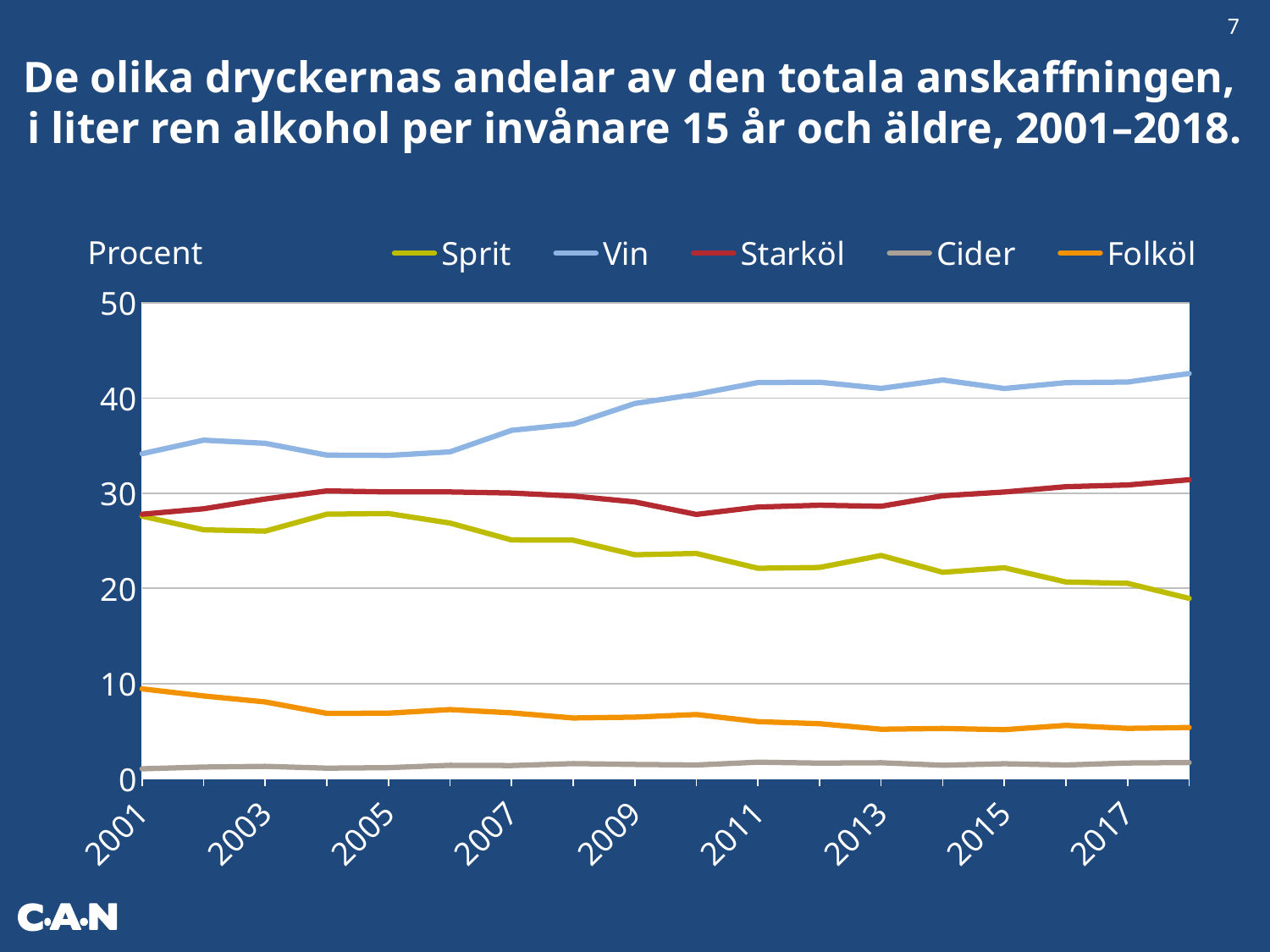
Is the value for Sprit in 2018 greater or less than 20? less How many series does the legend list? 5 Which series has the highest value in 2018? Vin What kind of chart is shown on the slide? line chart Does the value for Vin rise or fall from 2001 to 2018? rise Is the value for Vin in 2018 greater or less than 40? greater Is the value for Starköl in 2018 greater or less than 30? greater Which is larger in 2018, the value for Starköl or the value for Sprit? Starköl Which is larger in 2011, the value for Vin or the value for Folköl? Vin Which series has the lowest value across the whole period? Cider Does the value for Sprit rise or fall from 2001 to 2018? fall What label is shown on the vertical axis of the chart? Procent